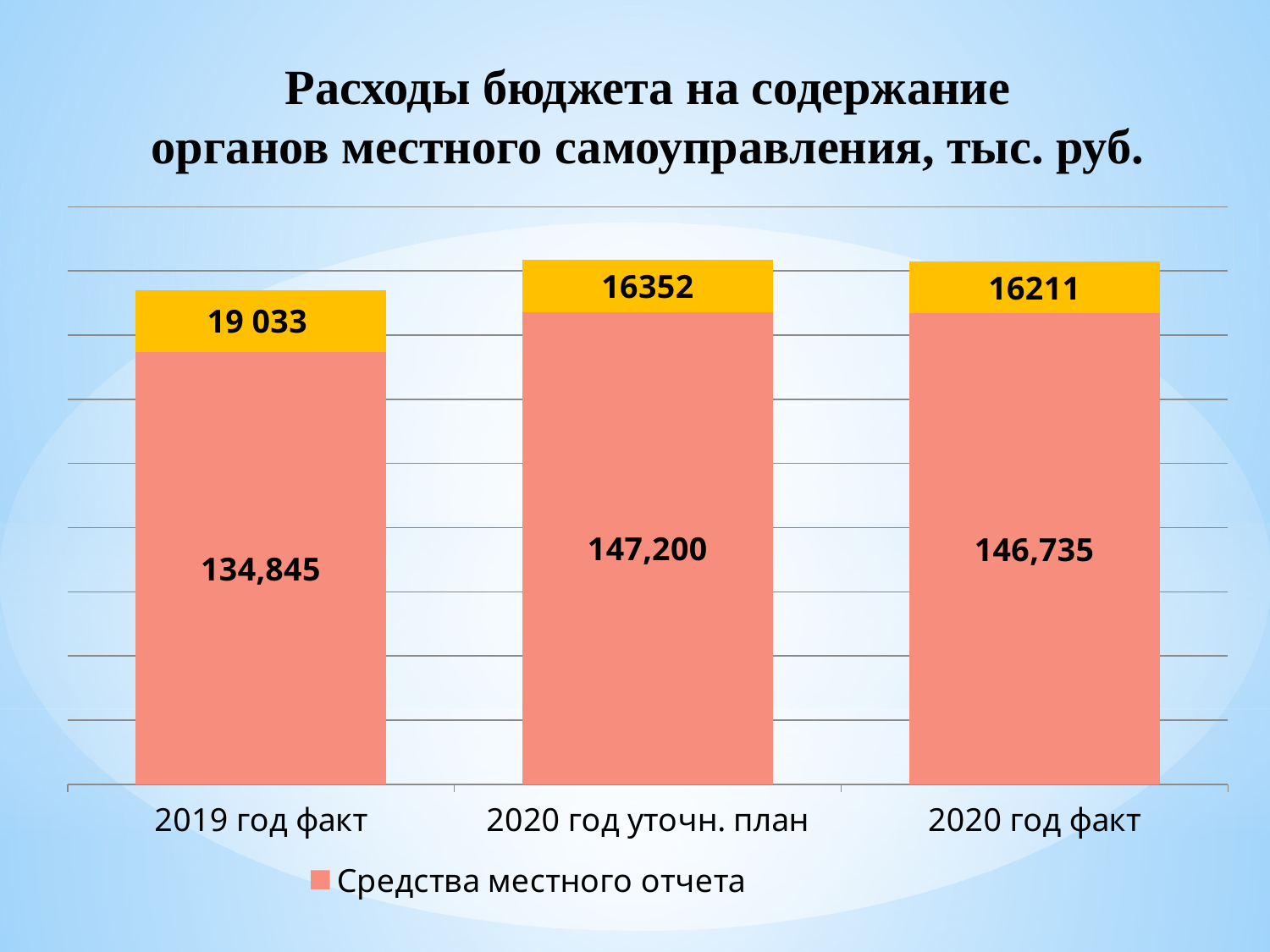
How many categories are shown on the x axis? 3 What is the value of the yellow top segment for "2019 год факт"? 19 033 What is the total of the stacked bar for "2019 год факт"? 153,878 How many series does the legend list? 1 Which category has the highest value of "Средства местного отчета"? 2020 год уточн. план What is the value of "Средства местного отчета" for "2019 год факт"? 134,845 What kind of chart is shown on the slide? stacked bar chart Which category has the lowest value of "Средства местного отчета"? 2019 год факт Which is larger: the yellow top segment for "2020 год уточн. план" or for "2020 год факт"? 2020 год уточн. план What is the value of "Средства местного отчета" for "2020 год факт"? 146,735 What is the value of "Средства местного отчета" for "2020 год уточн. план"? 147,200 What is the difference between "Средства местного отчета" for "2020 год уточн. план" and for "2019 год факт"? 12,355